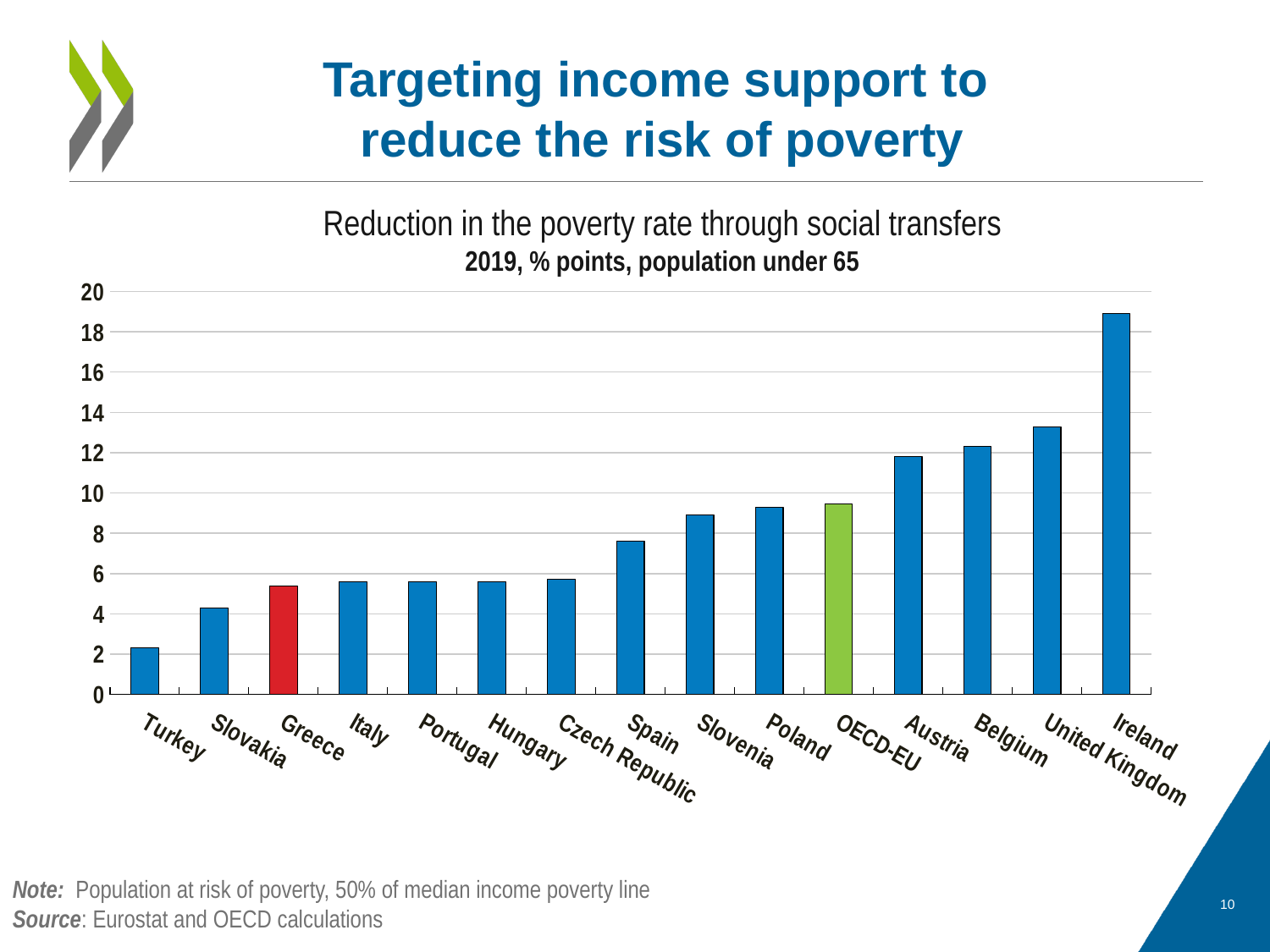
Is the value for Ireland greater or less than 18? greater Which country has the highest reduction in the poverty rate through social transfers? Ireland Do the values generally rise or fall moving from left to right along the x axis? rise How many countries or groups are shown on the x axis of the chart? 15 Is the value for Spain greater or less than 8? less What kind of chart is shown on the slide? bar chart Which country's bar is coloured red in the chart? Greece Which has a larger value, Austria or Poland? Austria Which country has the lowest reduction in the poverty rate through social transfers? Turkey Is the value for United Kingdom greater or less than 12? greater